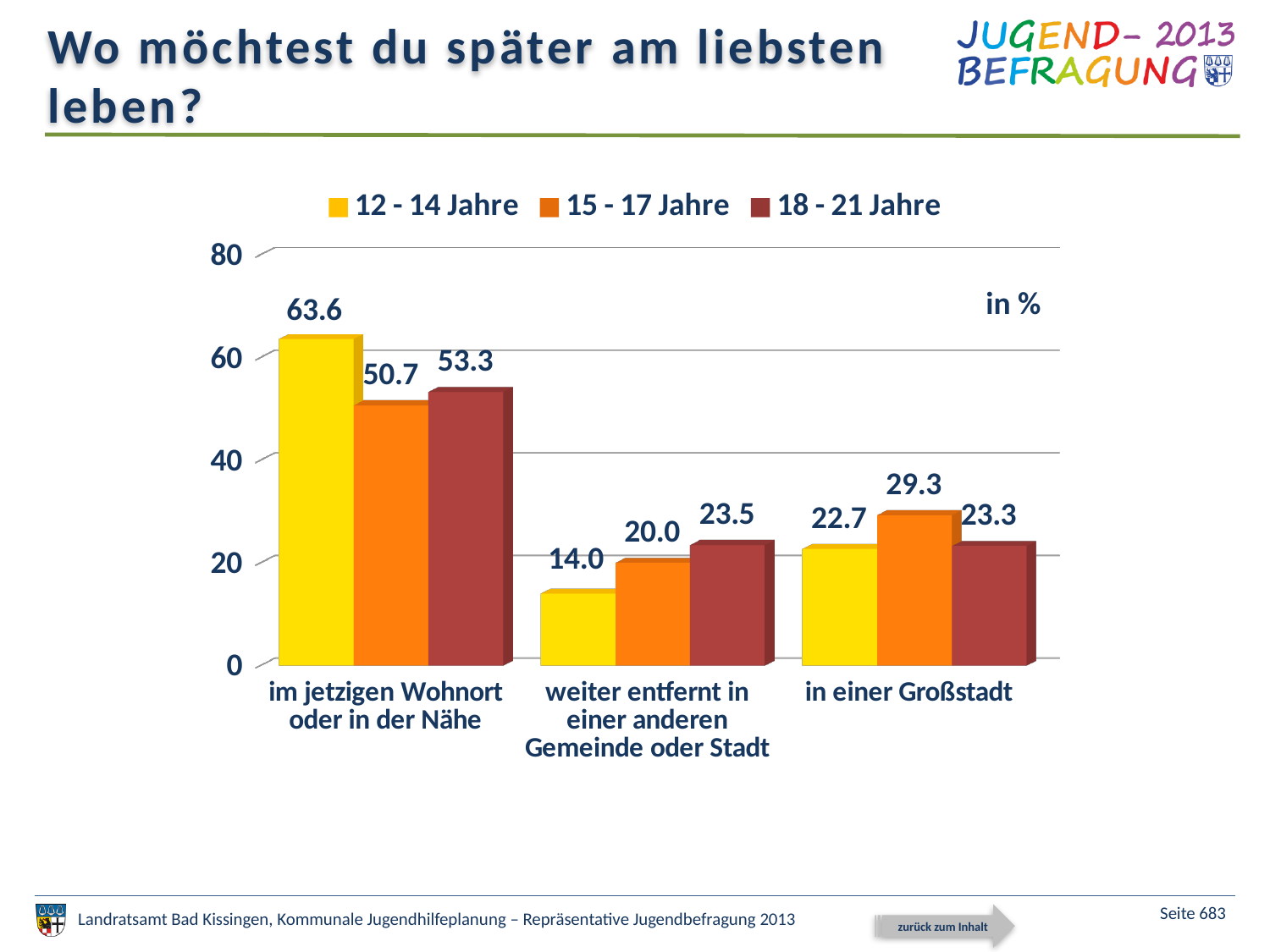
What is the difference between the 12 - 14 Jahre and 15 - 17 Jahre values in the category 'im jetzigen Wohnort oder in der Nähe'? 12.9 What is the value for the 12 - 14 Jahre series in the category 'im jetzigen Wohnort oder in der Nähe'? 63.6 What unit is indicated for the values in the chart? in % What is the value for the 18 - 21 Jahre series in the category 'in einer Großstadt'? 23.3 How many series does the legend list? 3 What is the value for the 15 - 17 Jahre series in the category 'weiter entfernt in einer anderen Gemeinde oder Stadt'? 20.0 Which category has the lowest value for the 12 - 14 Jahre series? weiter entfernt in einer anderen Gemeinde oder Stadt Is the value for the 18 - 21 Jahre series in the category 'im jetzigen Wohnort oder in der Nähe' greater or less than 40? greater Which category has the highest value for the 15 - 17 Jahre series? im jetzigen Wohnort oder in der Nähe What kind of chart is shown on the slide? bar chart In the category 'in einer Großstadt', which series has the larger value: 15 - 17 Jahre or 18 - 21 Jahre? 15 - 17 Jahre How many categories are shown on the x axis? 3